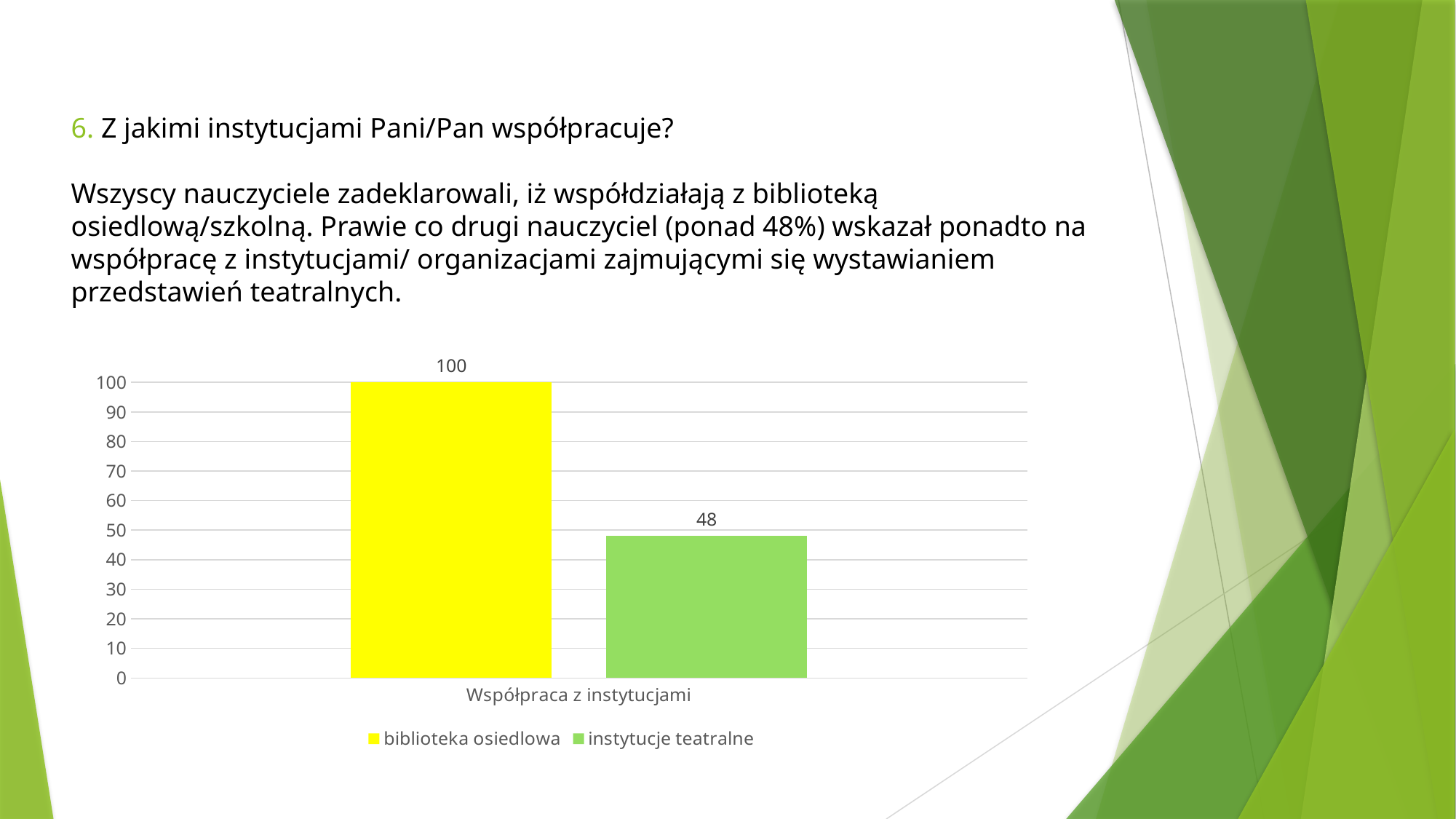
What kind of chart is shown on the slide? bar chart What colour is the bar for biblioteka osiedlowa? yellow What is the category label on the x axis of the chart? Współpraca z instytucjami How many series does the legend list? 2 Is the value for instytucje teatralne greater or less than 50? less What is the value for instytucje teatralne? 48 What is the difference between the values for biblioteka osiedlowa and instytucje teatralne? 52 Which series has the lowest value? instytucje teatralne Which is larger, the value for biblioteka osiedlowa or for instytucje teatralne? biblioteka osiedlowa Which series has the highest value? biblioteka osiedlowa What is the highest value shown on the y axis? 100 What is the value for biblioteka osiedlowa? 100